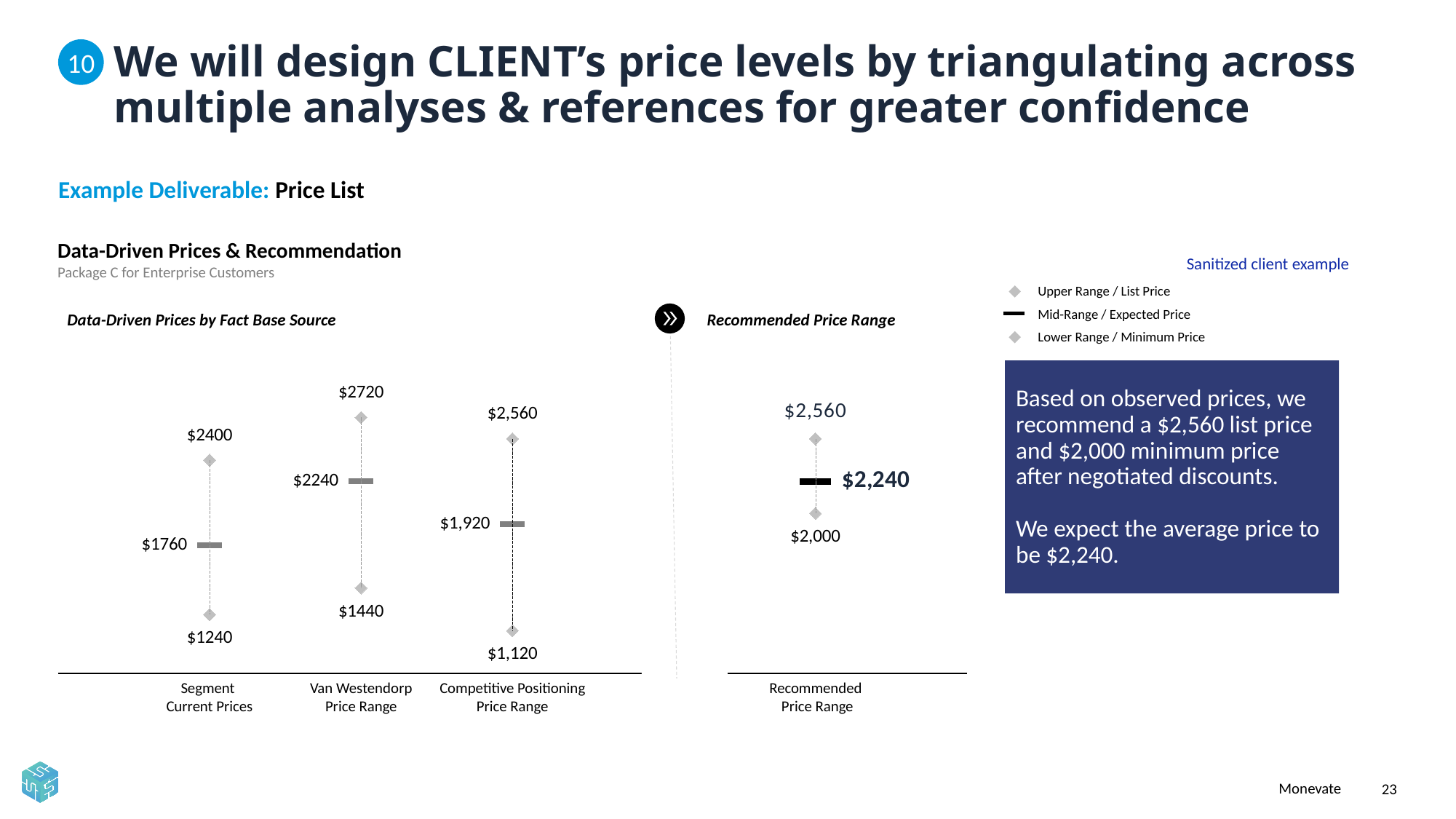
What does the horizontal bar marker represent according to the legend? Mid-Range / Expected Price How many sources are shown on the x axis of the 'Data-Driven Prices by Fact Base Source' chart? 3 In the 'Data-Driven Prices by Fact Base Source' chart, what is the lower range / minimum price for Competitive Positioning Price Range? $1,120 In the 'Data-Driven Prices by Fact Base Source' chart, which is larger: the mid-range price for Van Westendorp Price Range or for Competitive Positioning Price Range? Van Westendorp Price Range In the 'Data-Driven Prices by Fact Base Source' chart, what is the mid-range / expected price for Segment Current Prices? $1760 In the 'Recommended Price Range' chart, what is the mid-range / expected price? $2,240 In the 'Data-Driven Prices by Fact Base Source' chart, what is the upper range / list price for Van Westendorp Price Range? $2720 In the 'Data-Driven Prices by Fact Base Source' chart, what is the difference between the upper and lower range for Segment Current Prices? $1160 In the 'Recommended Price Range' chart, what is the lower range / minimum price? $2,000 How many series does the legend list for the price range charts? 3 In the 'Data-Driven Prices by Fact Base Source' chart, which source has the lowest lower range / minimum price? Competitive Positioning Price Range In the 'Data-Driven Prices by Fact Base Source' chart, which source has the highest upper range / list price? Van Westendorp Price Range